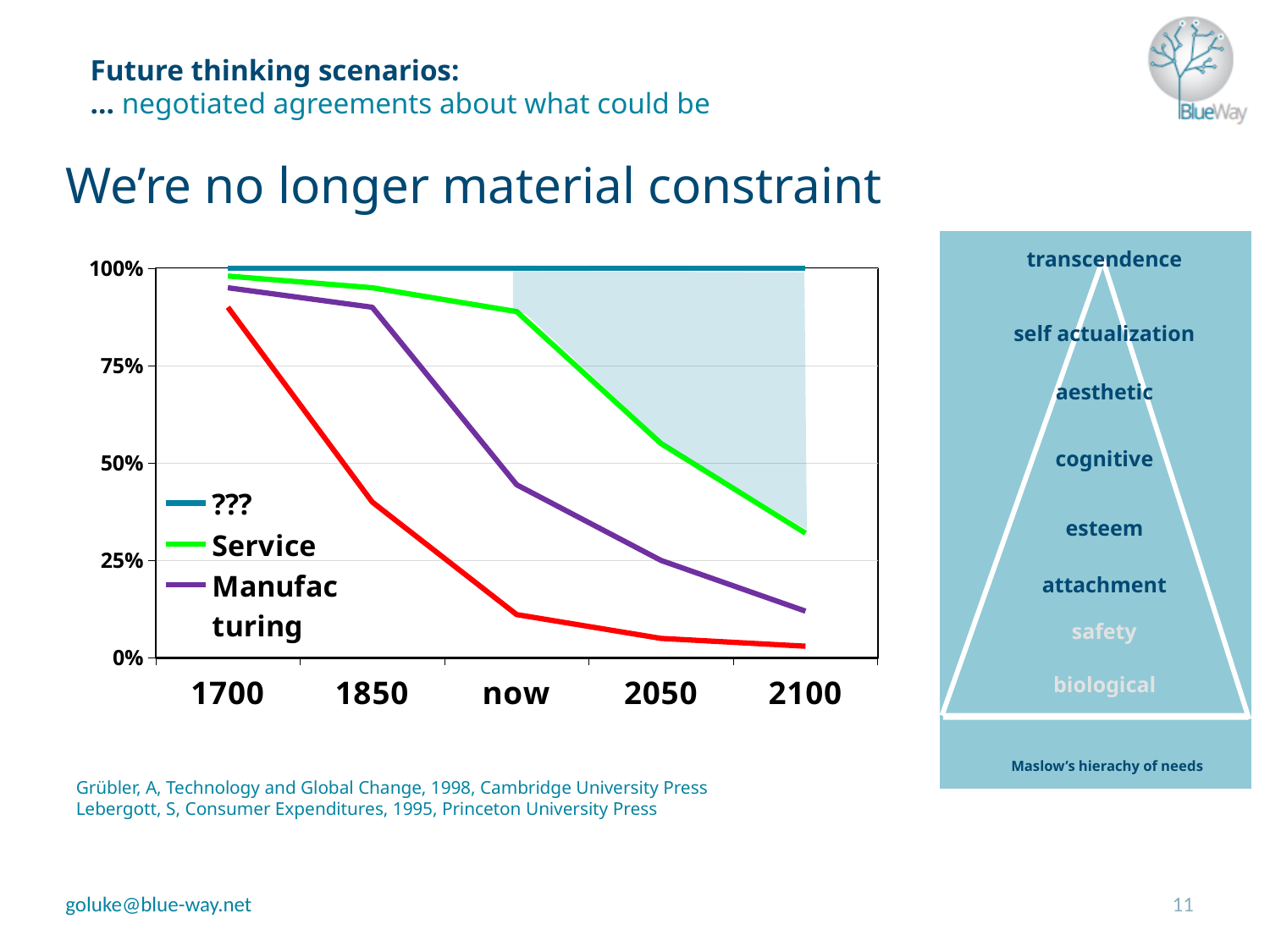
How many series does the chart legend list? 3 What kind of chart is shown on the slide? line chart Does the Service line rise or fall from 1700 to 2100? fall How many labelled points are there along the x axis of the chart? 5 Is the value of the Service line at 2050 greater or less than 50%? greater Is the value of the Service line at 2100 greater or less than 25%? greater Is the value of the Manufacturing line at 2100 greater or less than 25%? less Which legend entry is shown with a green line? Service What is the label of the first x-axis category on the chart? 1700 At 2050, which is larger: the Service line or the Manufacturing line? Service